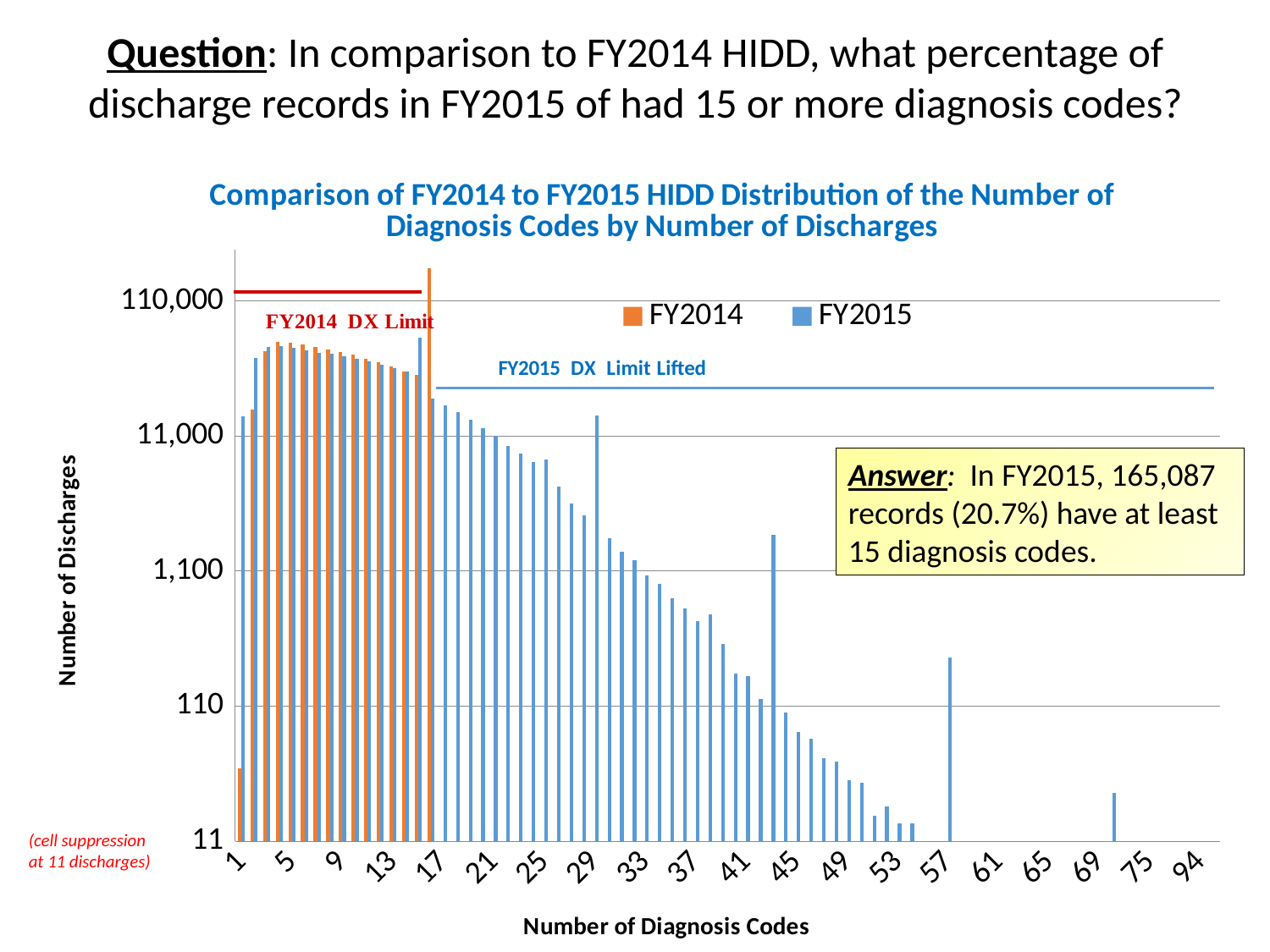
Is the FY2014 value for 1 diagnosis code greater or less than 110? less What is the title of the chart's vertical axis? Number of Discharges At which number of diagnosis codes is the FY2014 series highest? 16 How many series does the chart legend list? 2 For 16 diagnosis codes, which series has the larger number of discharges, FY2014 or FY2015? FY2014 Is the FY2015 value for 5 diagnosis codes greater or less than 11,000? greater Beyond about 5 diagnosis codes, do the FY2015 values generally rise or fall as the number of diagnosis codes increases? fall For 1 diagnosis code, which series has the larger number of discharges, FY2014 or FY2015? FY2015 What are the two series named in the chart legend? FY2014 and FY2015 What kind of chart is shown on the slide? bar chart Is the FY2015 value for 57 diagnosis codes greater or less than 1,100? less At which number of diagnosis codes is the FY2014 series lowest? 1